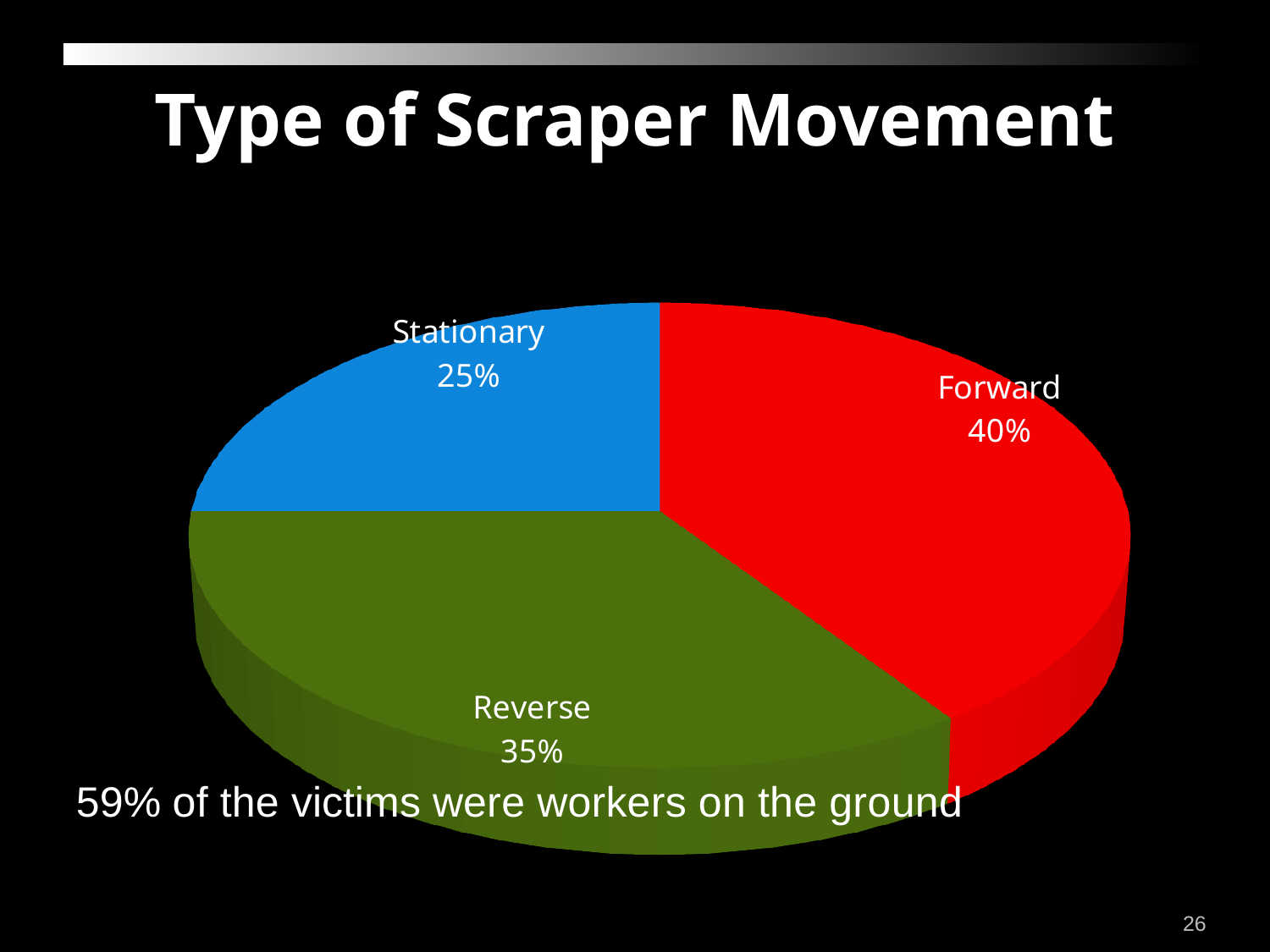
What percentage of scraper movement is Reverse? 35% Which type of scraper movement has the smallest share? Stationary What percentage of scraper movement is Forward? 40% What colour is the Reverse slice of the pie chart? Green What percentage of scraper movement is Stationary? 25% Which type of scraper movement has the largest share? Forward Which is larger, the Reverse share or the Stationary share? Reverse What is the difference in percentage points between Forward and Reverse? 5 What is the difference in percentage points between Forward and Stationary? 15 How many categories are shown in the pie chart? 3 What kind of chart is shown on the slide? Pie chart What is the title of the chart? Type of Scraper Movement